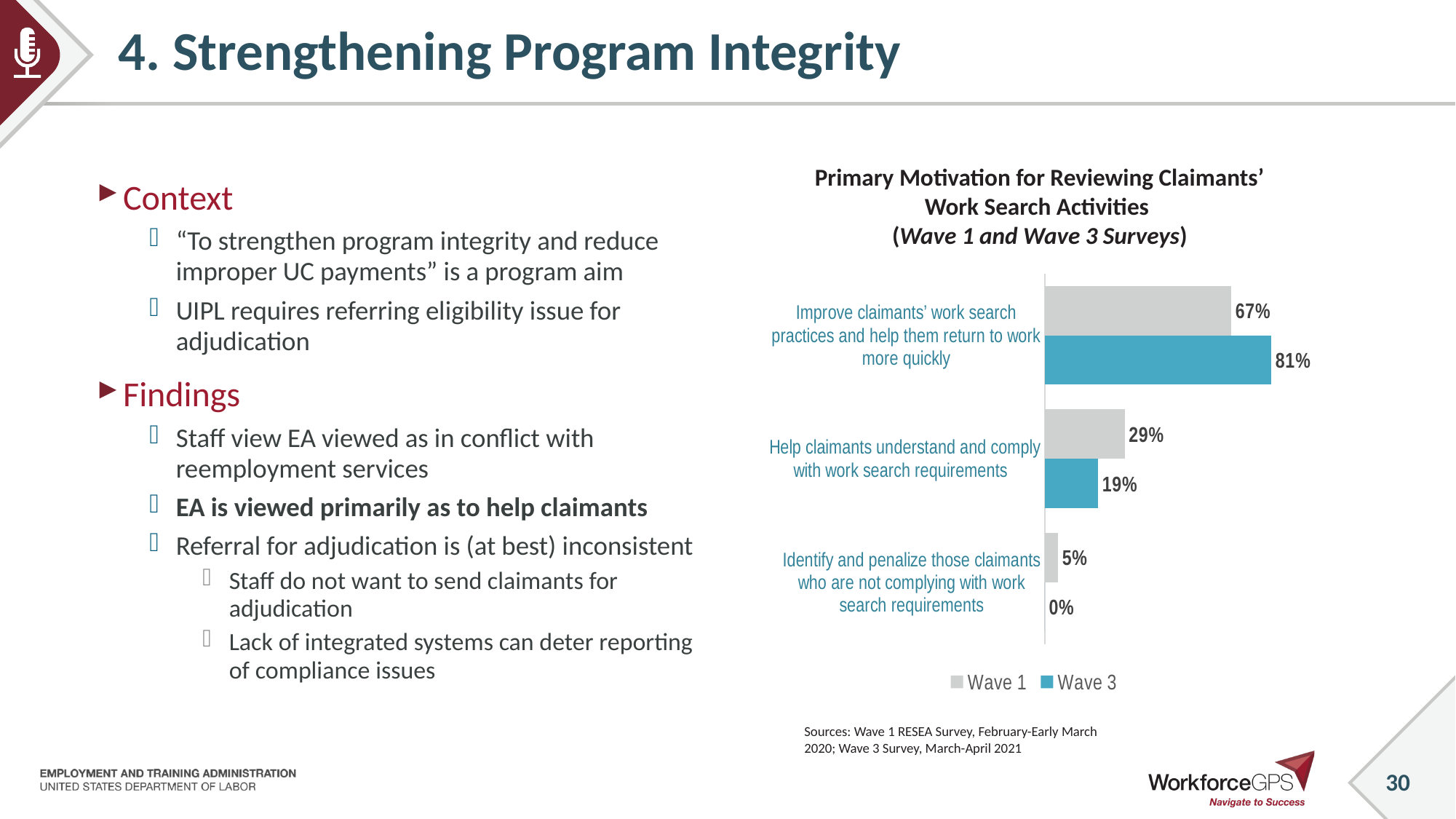
What is the Wave 1 value for "Identify and penalize those claimants who are not complying with work search requirements"? 5% For "Help claimants understand and comply with work search requirements", which is larger, the Wave 1 or Wave 3 value? Wave 1 Which category has the lowest Wave 3 value? Identify and penalize those claimants who are not complying with work search requirements How many series does the legend list? 2 What kind of chart is shown on the slide? Bar chart What is the Wave 3 value for "Improve claimants' work search practices and help them return to work more quickly"? 81% What is the Wave 1 value for "Help claimants understand and comply with work search requirements"? 29% Which category has the highest Wave 1 value? Improve claimants' work search practices and help them return to work more quickly What is the Wave 3 value for "Identify and penalize those claimants who are not complying with work search requirements"? 0% What is the difference between the Wave 3 and Wave 1 values for "Improve claimants' work search practices and help them return to work more quickly"? 14% Which series is shown in blue in the chart? Wave 3 How many categories are shown in the chart? 3